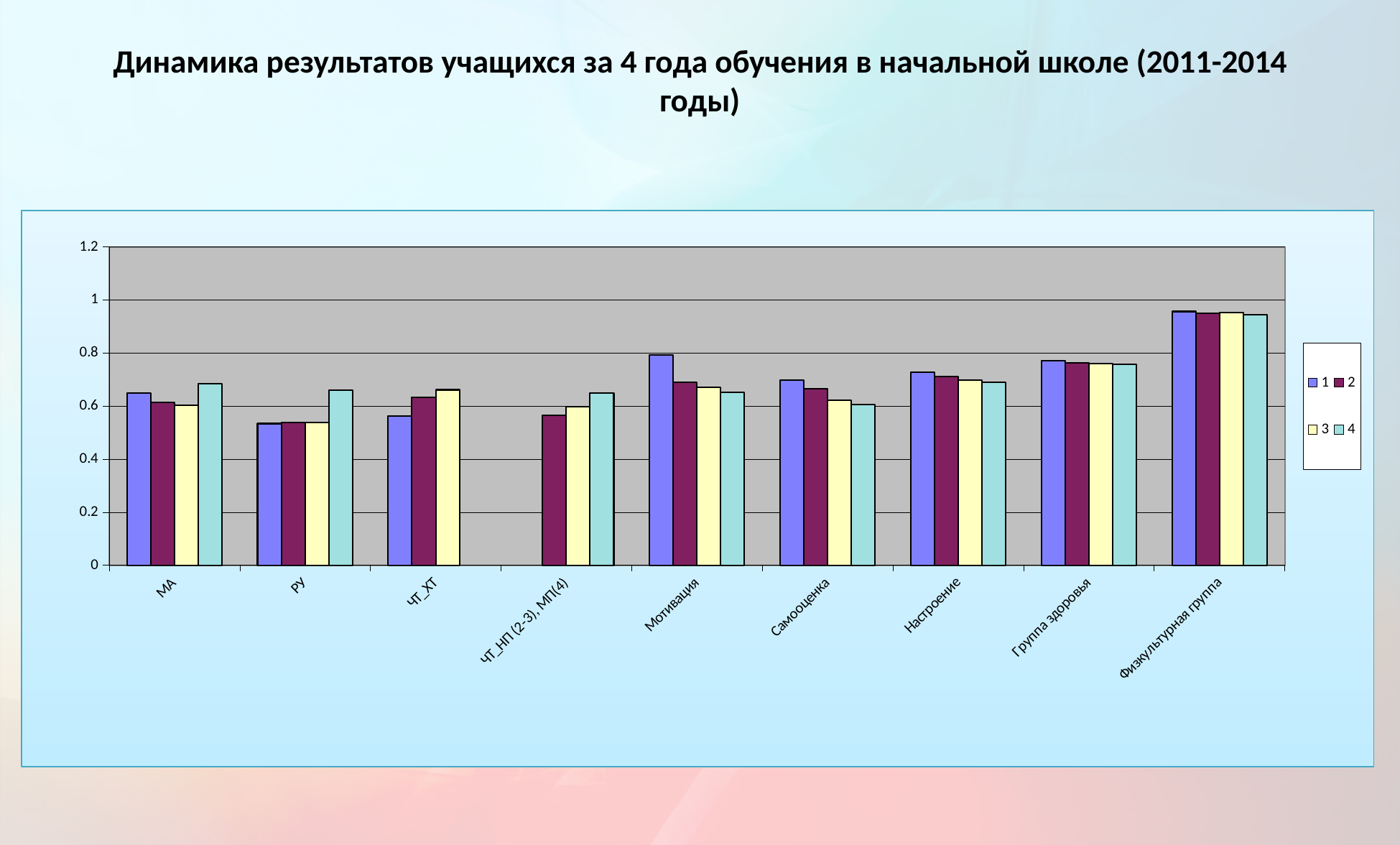
Which category has the highest values across all series? Физкультурная группа Is the value for series 1 in Мотивация greater or less than 0.6? greater Is the value for series 1 in Физкультурная группа greater or less than 1? less Is the value for series 1 in Группа здоровья greater or less than 0.6? greater For Мотивация, which is larger: the value for series 1 or series 4? series 1 Which category has no bar for series 1? ЧТ_НП (2-3), МП(4) Which category has the lowest value for series 4? Самооценка What kind of chart is shown on the slide? bar chart How many series does the chart legend list? 4 For РУ, which is larger: the value for series 1 or series 4? series 4 How many categories are shown along the x axis of the chart? 9